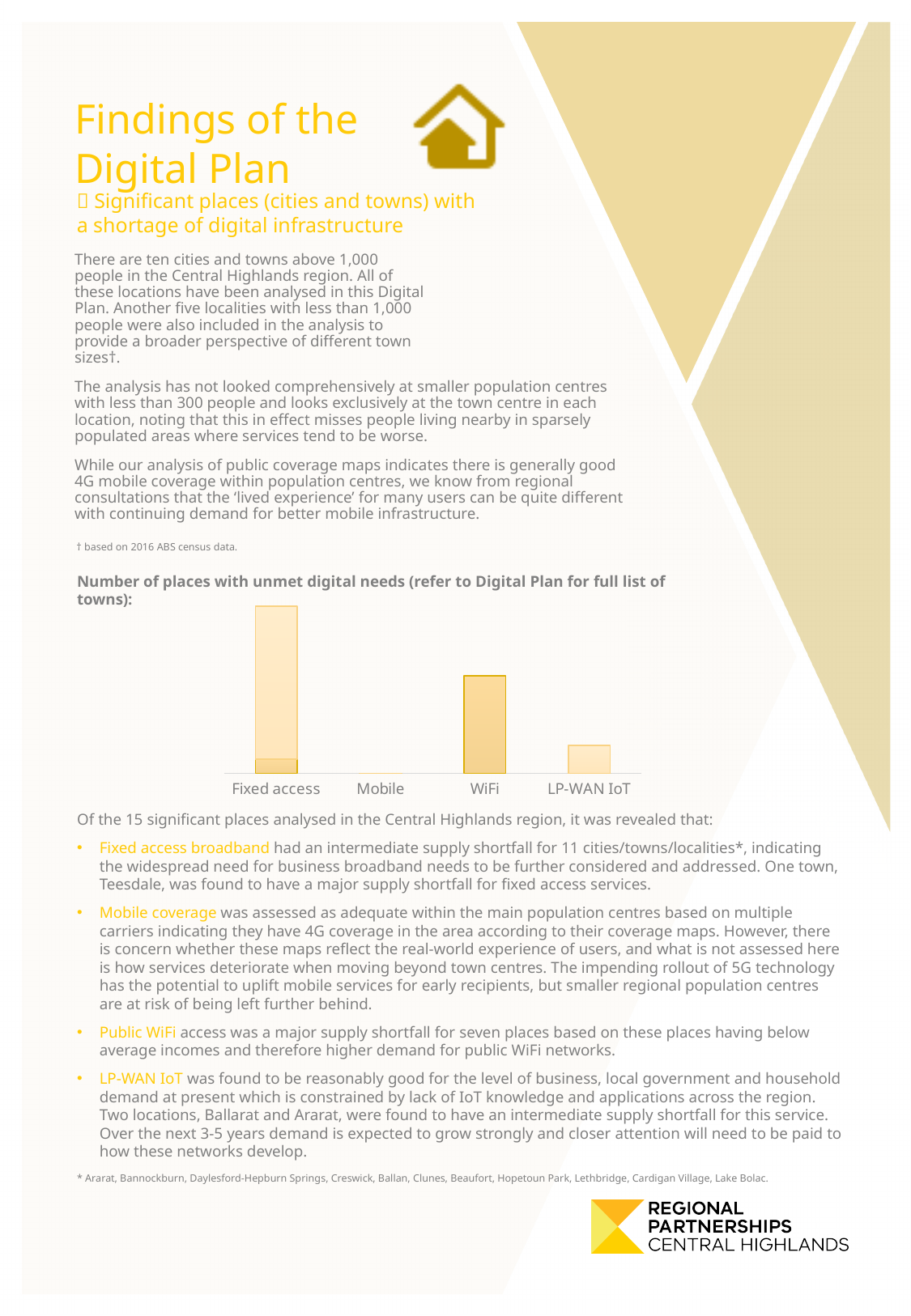
Which has the larger bar in the chart, Fixed access or WiFi? Fixed access Which category in the chart has no visible bar? Mobile Which has the larger bar in the chart, WiFi or LP-WAN IoT? WiFi Which category has the lowest value in the chart? Mobile How many categories are shown on the x axis of the chart? 4 What kind of chart is shown on the slide? bar chart Which category has the tallest bar in the chart? Fixed access What is the title of the chart? Number of places with unmet digital needs Which has the larger bar in the chart, Mobile or LP-WAN IoT? LP-WAN IoT